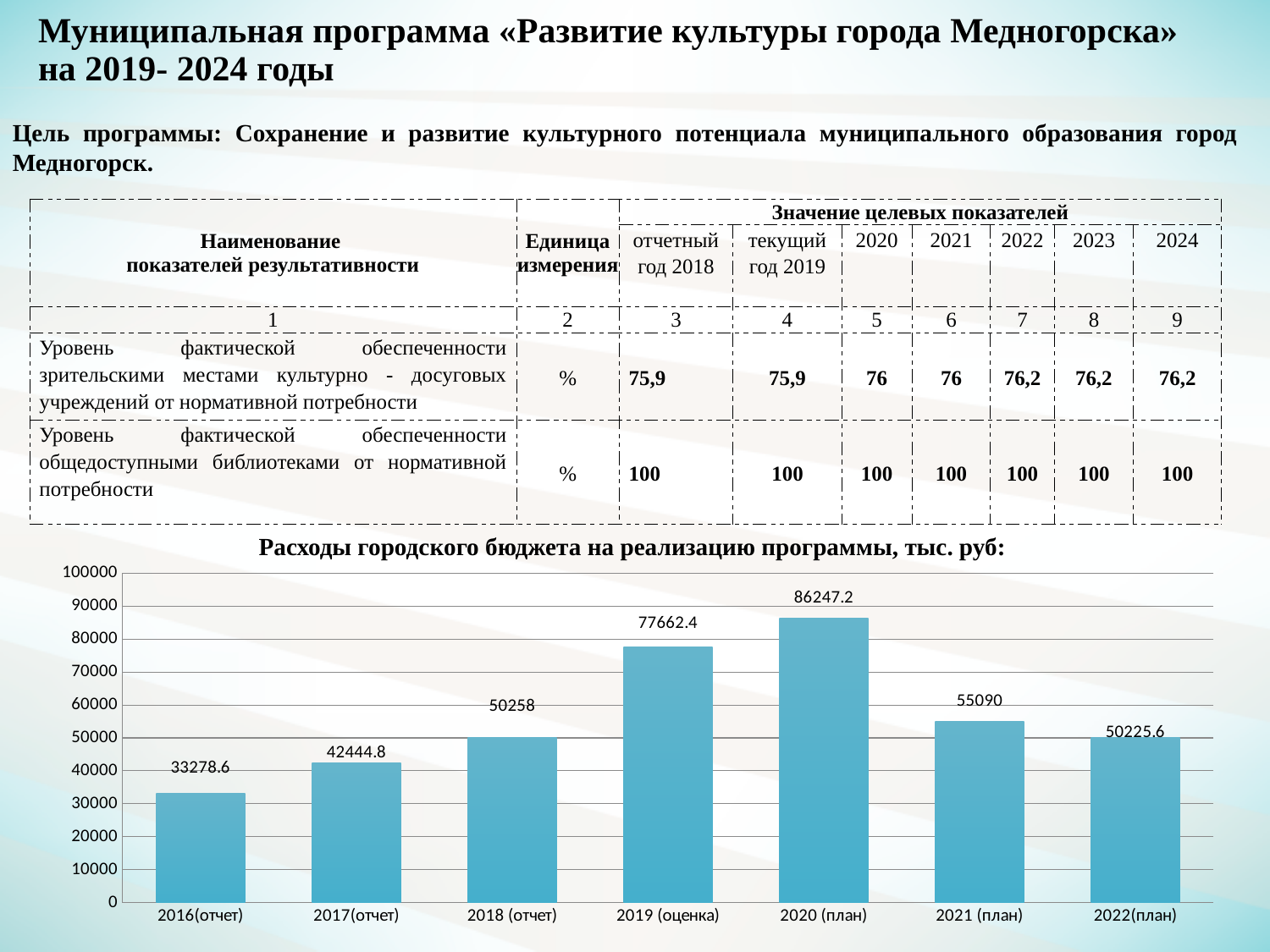
What is the value for 2020 (план) in the chart? 86247.2 What is the value for 2016(отчет) in the chart? 33278.6 What is the difference between the values for 2017(отчет) and 2016(отчет)? 9166.2 Is the value for 2018 (отчет) greater or less than 60000? less What is the value for 2019 (оценка) in the chart? 77662.4 Which is larger, the value for 2021 (план) or the value for 2022(план)? 2021 (план) Which category has the lowest value in the chart? 2016(отчет) What is the difference between the values for 2020 (план) and 2019 (оценка)? 8584.8 How many categories are shown in the chart? 7 What type of chart is shown on the slide? bar chart Which category has the highest value in the chart? 2020 (план) What is the value for 2022(план) in the chart? 50225.6